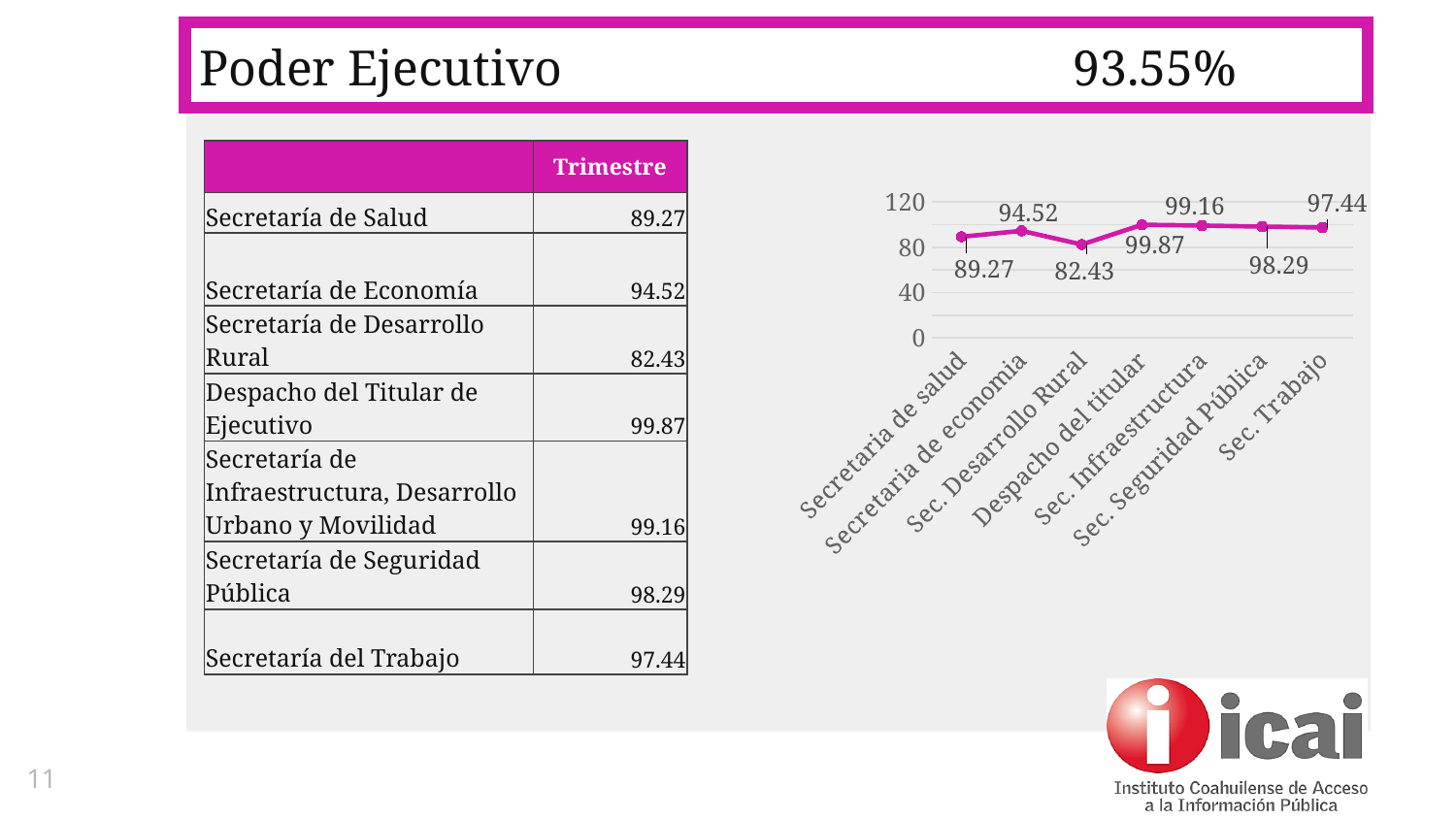
Which category has the lowest value in the chart? Sec. Desarrollo Rural What is the value plotted for Sec. Trabajo? 97.44 Is the value for Sec. Infraestructura greater or less than 80? greater Which is larger, the value for Secretaría de economía or the value for Sec. Seguridad Pública? Sec. Seguridad Pública What is the value plotted for Secretaría de salud? 89.27 What kind of chart is shown on the slide? Line chart What is the value plotted for Sec. Desarrollo Rural? 82.43 How many categories are plotted along the x axis of the chart? 7 What is the difference between the values for Despacho del titular and Sec. Desarrollo Rural? 17.44 What is the highest tick value shown on the chart's vertical axis? 120 Which category has the highest value in the chart? Despacho del titular Does the line rise or fall between Secretaría de economía and Sec. Desarrollo Rural? Fall